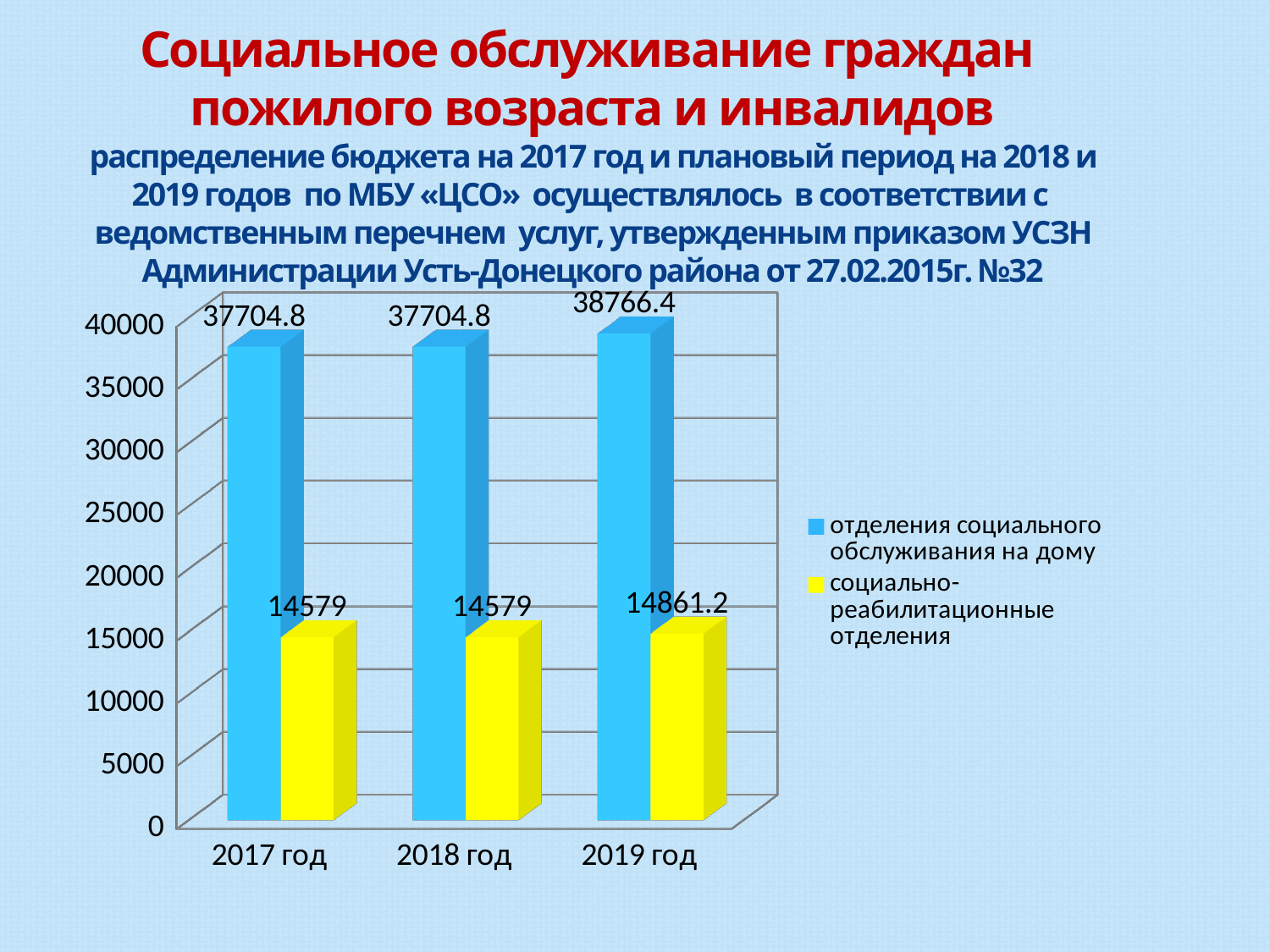
What is the difference between the социально-реабилитационные отделения value in 2019 год and in 2017 год? 282.2 In which year is the value for отделения социального обслуживания на дому highest? 2019 год How many year categories are shown on the x axis? 3 What is the value for отделения социального обслуживания на дому in 2017 год? 37704.8 Which colour represents социально-реабилитационные отделения in the chart? yellow How many series does the legend list? 2 What is the value for социально-реабилитационные отделения in 2018 год? 14579 Is the value for социально-реабилитационные отделения in 2017 год greater or less than 15000? less What is the difference between the отделения социального обслуживания на дому value in 2019 год and in 2018 год? 1061.6 Which series has the larger value in 2019 год, отделения социального обслуживания на дому or социально-реабилитационные отделения? отделения социального обслуживания на дому What is the value for социально-реабилитационные отделения in 2019 год? 14861.2 What kind of chart is shown on the slide? bar chart